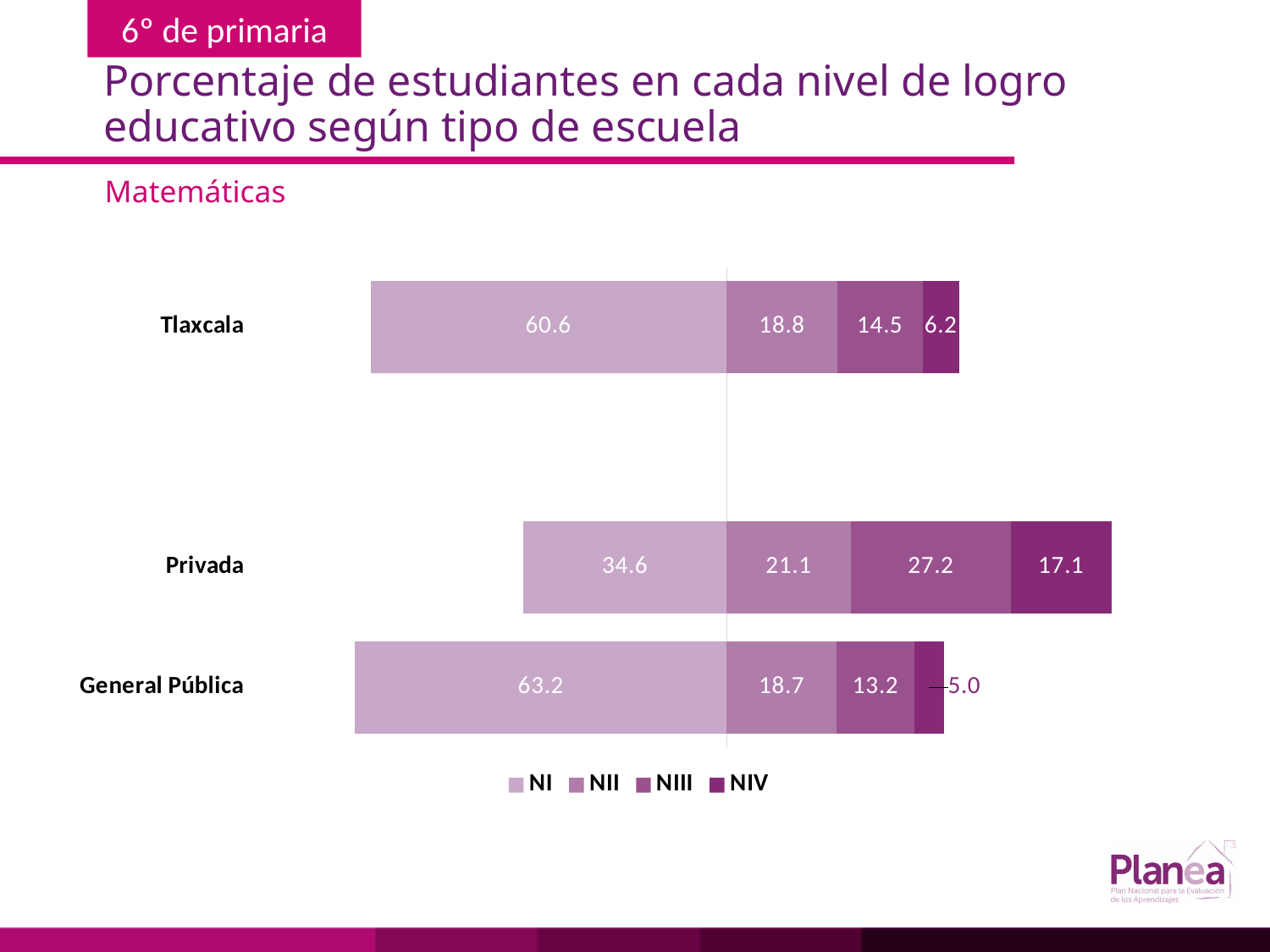
What is the NIV value for Privada? 17.1 What is the NII value for Privada? 21.1 What is the NIII value for General Pública? 13.2 How many series does the legend list? 4 Which category has the lowest NIV value? General Pública Which category has the highest NI value? General Pública Which is larger, the NIII value for Privada or the NIII value for Tlaxcala? Privada What is the NI value for Tlaxcala? 60.6 What kind of chart is shown on the slide? Stacked bar chart What is the difference between the NI values for General Pública and Privada? 28.6 How many categories are shown on the chart? 3 What is the total of the stacked bar for Privada? 100.0